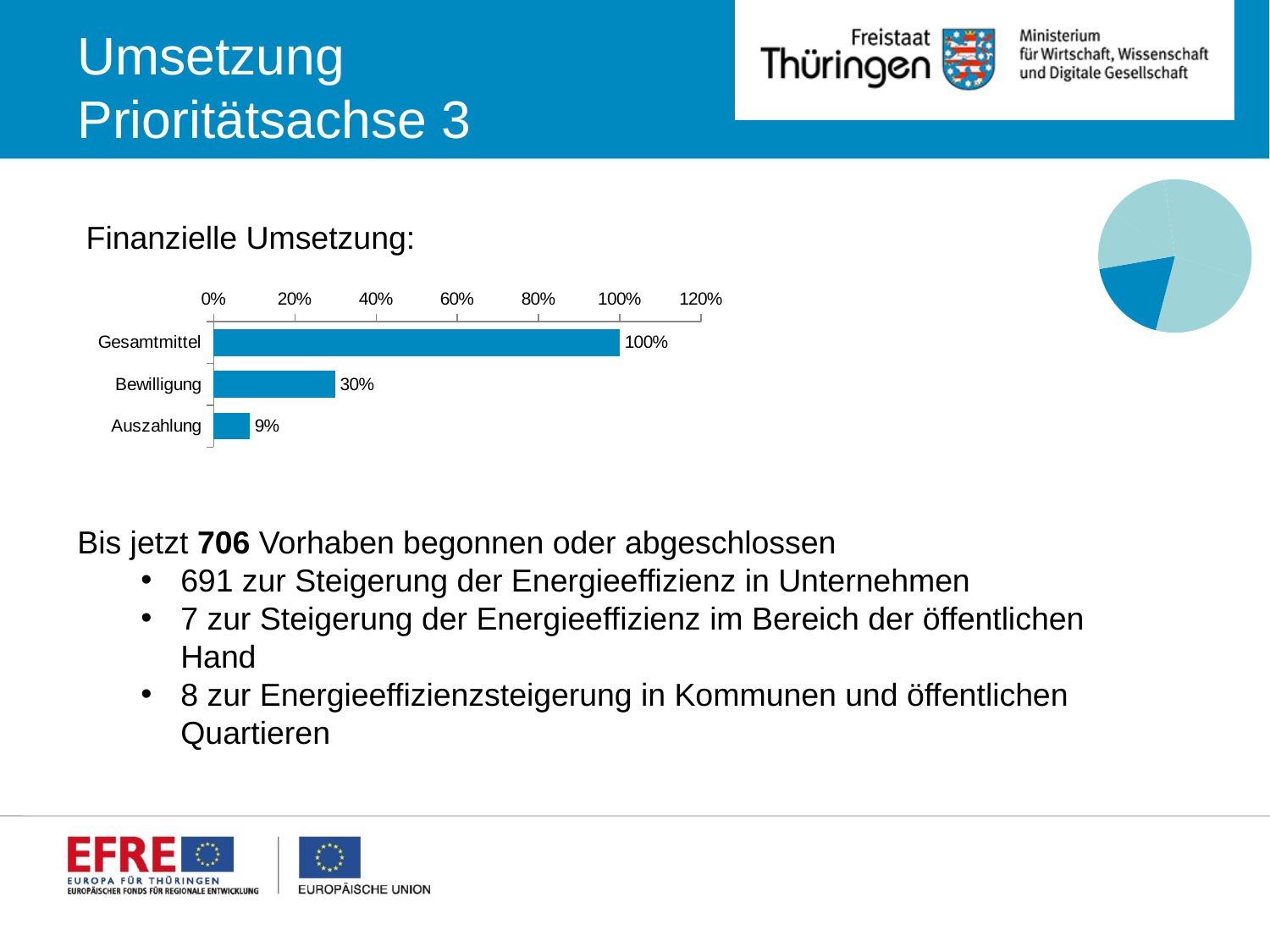
In the bar chart under "Finanzielle Umsetzung", what is the value for Bewilligung? 30% In the bar chart under "Finanzielle Umsetzung", is the value for Bewilligung greater or less than 40%? less In the bar chart under "Finanzielle Umsetzung", which is larger, Bewilligung or Auszahlung? Bewilligung In the bar chart under "Finanzielle Umsetzung", what is the difference between Bewilligung and Auszahlung? 21% What is the highest tick value on the x axis of the bar chart under "Finanzielle Umsetzung"? 120% In the bar chart under "Finanzielle Umsetzung", which category has the highest value? Gesamtmittel In the bar chart under "Finanzielle Umsetzung", what is the value for Gesamtmittel? 100% In the bar chart under "Finanzielle Umsetzung", what is the value for Auszahlung? 9% How many categories are shown in the bar chart under "Finanzielle Umsetzung"? 3 What kind of chart is shown under "Finanzielle Umsetzung"? bar chart In the bar chart under "Finanzielle Umsetzung", what is the difference between Gesamtmittel and Bewilligung? 70% In the bar chart under "Finanzielle Umsetzung", which category has the lowest value? Auszahlung